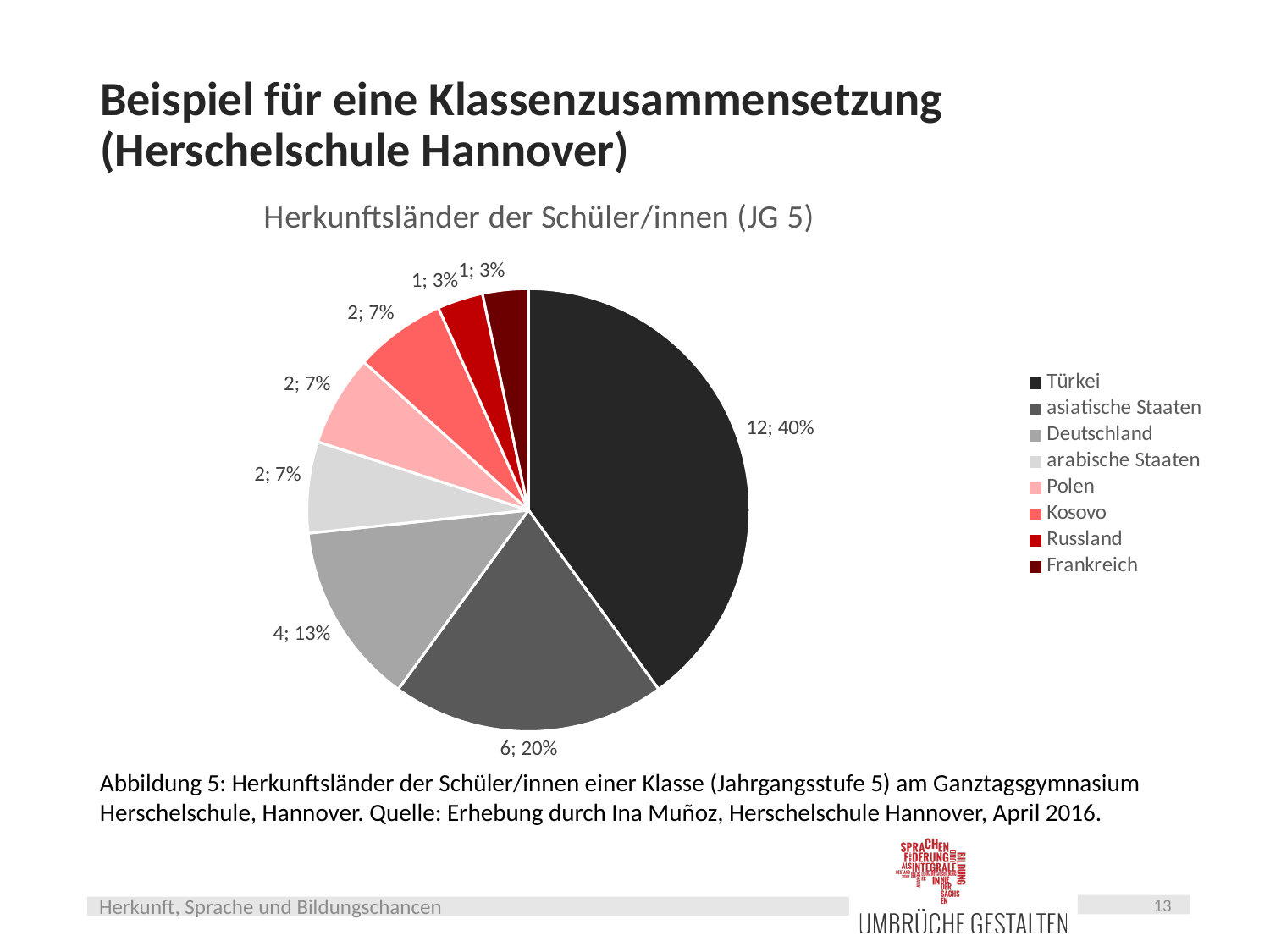
What share of the pie does the asiatische Staaten slice represent? 20% What percentage share is shown for the Frankreich slice? 3% How many more students are in the Türkei slice than in the asiatische Staaten slice? 6 What percentage share is shown for the Kosovo slice? 7% Which category has the largest slice of the pie? Türkei What is the data label shown for the Türkei slice? 12; 40% How many categories does the legend of the pie chart list? 8 How many students are in the Deutschland slice? 4 What is the total number of students represented in the pie chart? 30 What is the title of the chart? Herkunftsländer der Schüler/innen (JG 5) What kind of chart is shown on the slide? pie chart Which slice is larger, Deutschland or Polen? Deutschland